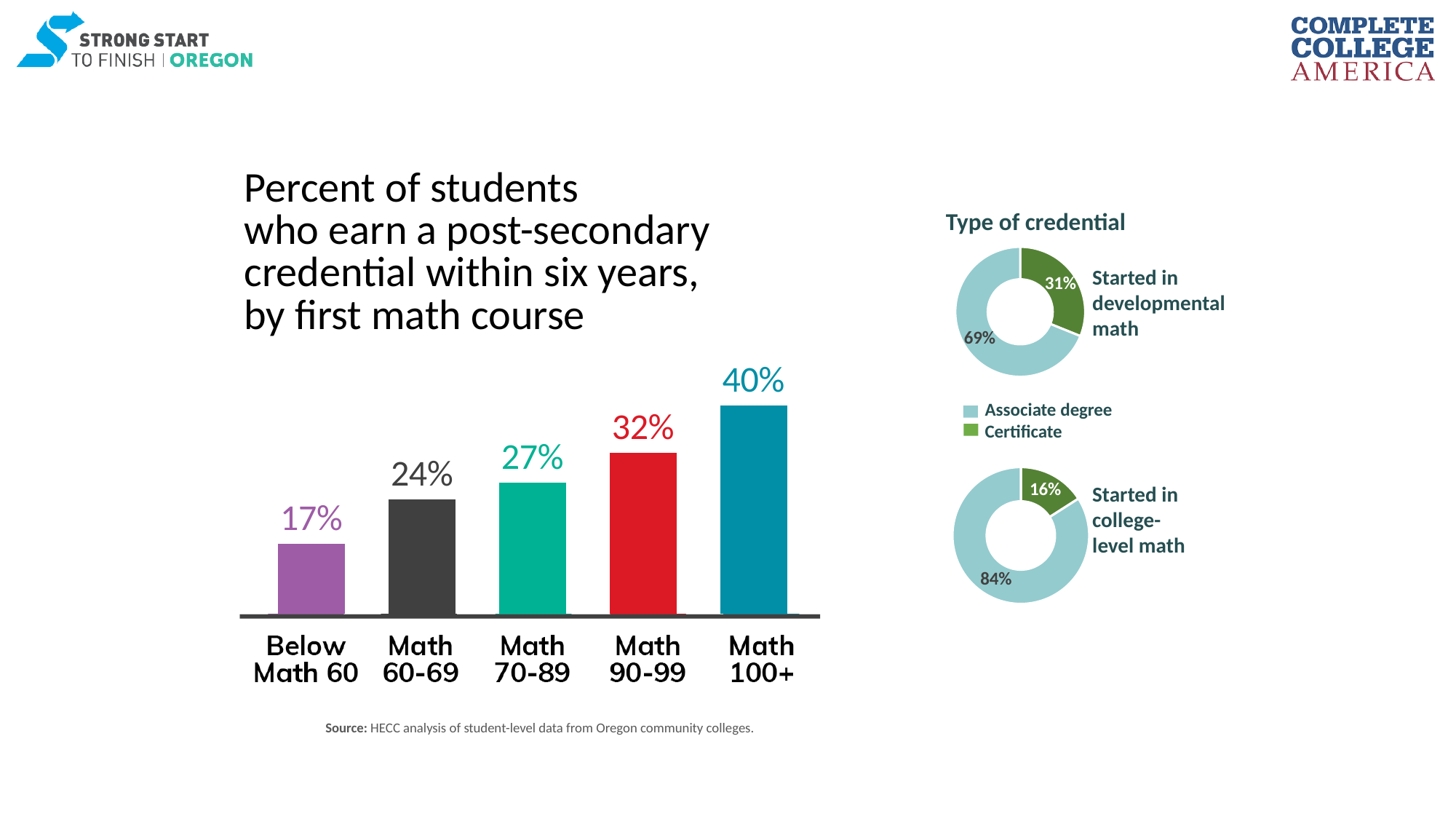
In the bar chart on the left, which first math course has the highest percent of students earning a credential? Math 100+ How many first math course categories are shown in the bar chart on the left? 5 In the 'Type of credential' donut chart for students who started in developmental math, what share is Certificate? 31% In the bar chart on the left, which first math course has the lowest percent of students earning a credential? Below Math 60 In the 'Type of credential' donut chart for students who started in college-level math, what share is Associate degree? 84% In the bar chart on the left, do the values rise or fall from Below Math 60 to Math 100+? Rise In the bar chart on the left, what is the difference between the values for Math 100+ and Math 90-99? 8% In the bar chart 'Percent of students who earn a post-secondary credential within six years, by first math course', what is the value for Math 70-89? 27% In the bar chart on the left, what is the value for Below Math 60? 17% What kind of chart is the chart on the left of the slide? Bar chart In the bar chart on the left, which is larger: the value for Math 60-69 or Math 70-89? Math 70-89 How many entries does the legend of the 'Type of credential' donut charts list? 2